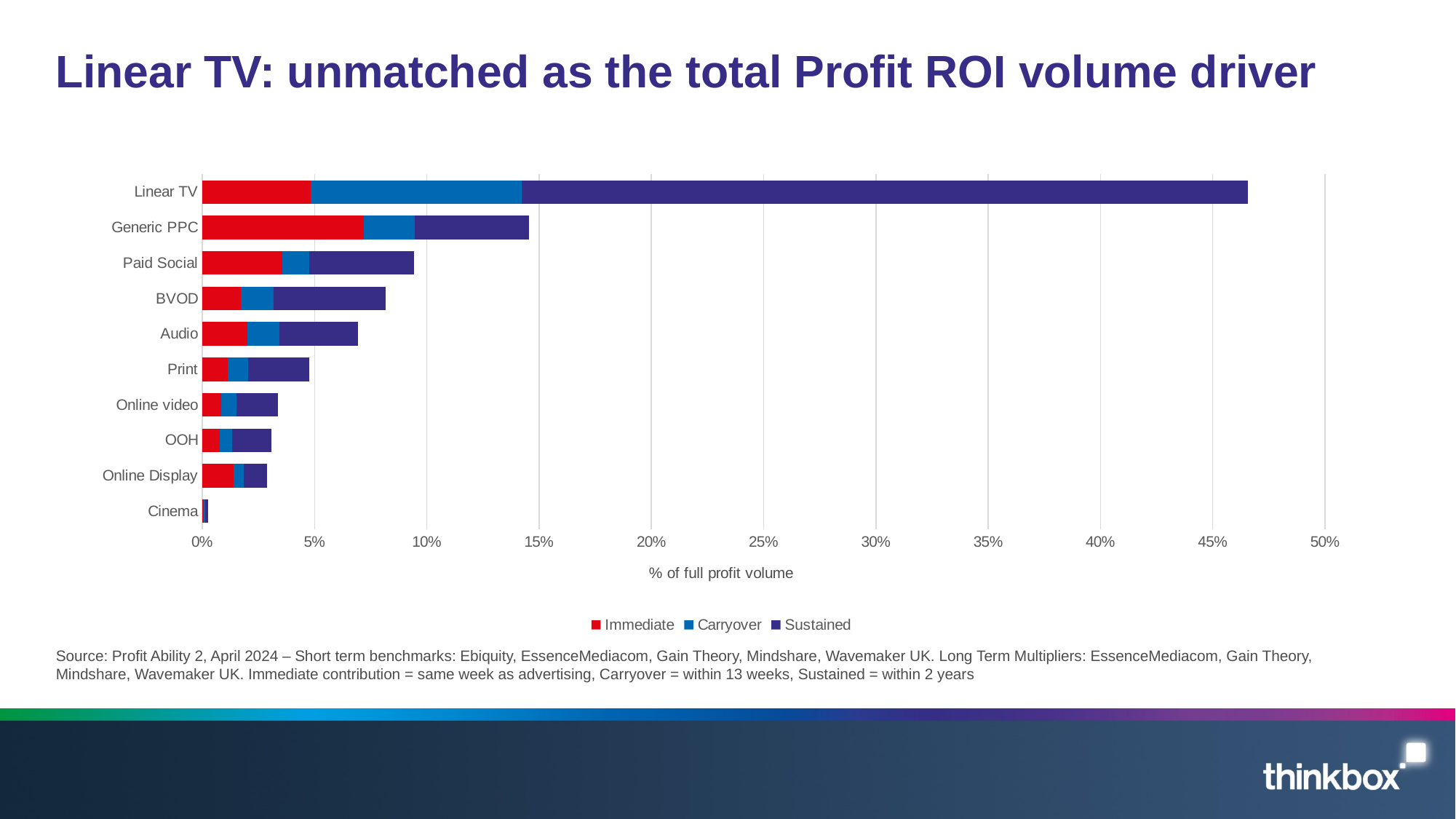
Is the total value for Paid Social greater or less than 10%? less Is the total value for Audio greater or less than 5%? greater How many series does the legend list? 3 Is the total value for Generic PPC greater or less than 15%? less What is the title of the horizontal axis? % of full profit volume How many media channels (categories) are plotted on the chart? 10 What kind of chart is shown on the slide? Stacked bar chart Which has a larger total % of full profit volume, Generic PPC or Paid Social? Generic PPC Which has a larger total % of full profit volume, BVOD or Audio? BVOD Which channel has the highest total % of full profit volume? Linear TV Which channel has the lowest total % of full profit volume? Cinema